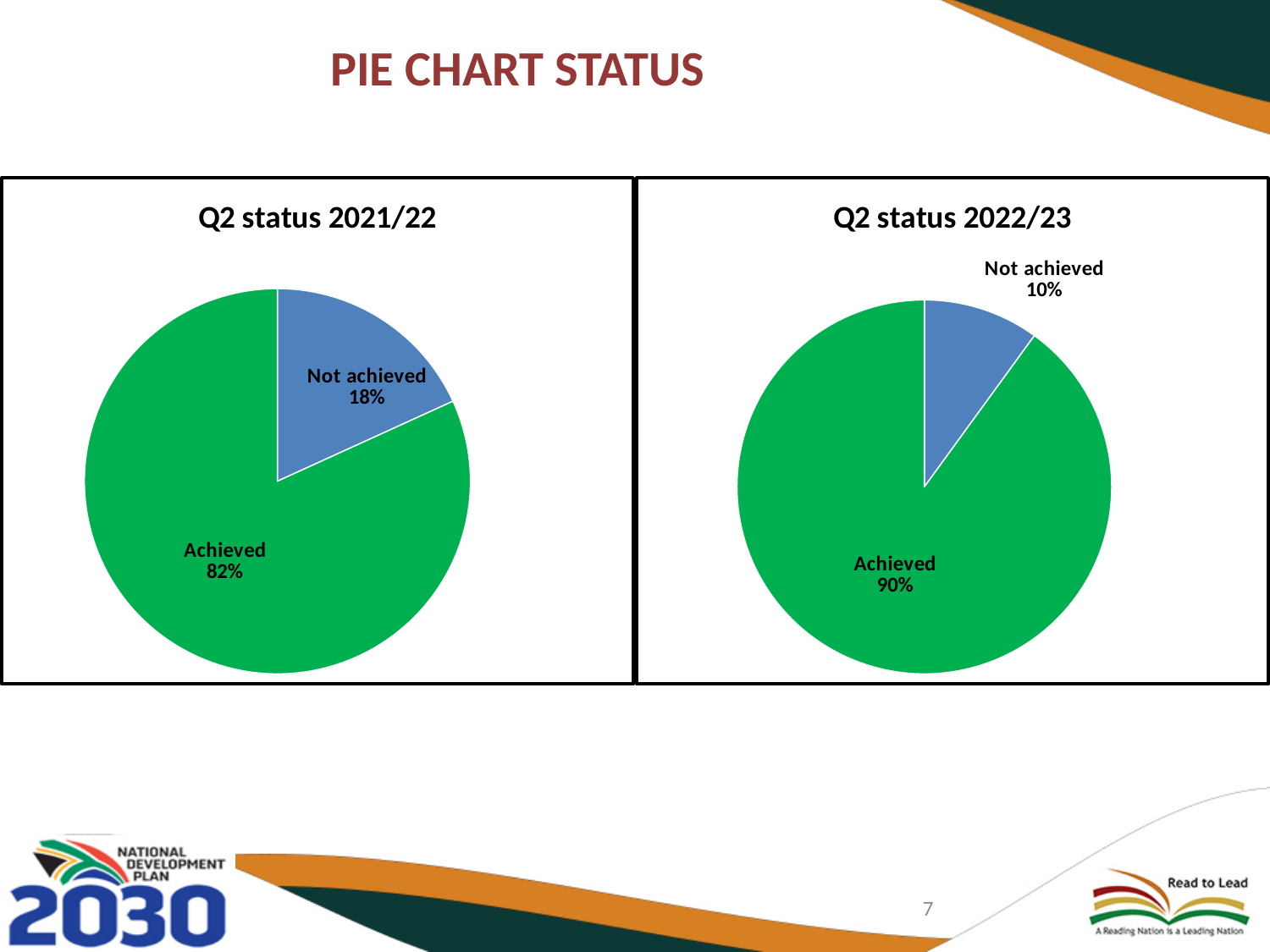
In the 'Q2 status 2022/23' chart, which slice is the smallest? Not achieved Which chart has the larger 'Achieved' share, 'Q2 status 2021/22' or 'Q2 status 2022/23'? Q2 status 2022/23 In the 'Q2 status 2021/22' chart, what share of the pie is 'Not achieved'? 18% How many charts are shown on the slide? 2 In the 'Q2 status 2021/22' chart, what is the difference between the 'Achieved' and 'Not achieved' shares? 64% How many slices does the 'Q2 status 2021/22' pie chart have? 2 In the 'Q2 status 2022/23' chart, what colour is the 'Not achieved' slice? Blue In the 'Q2 status 2021/22' chart, what share of the pie is 'Achieved'? 82% In the 'Q2 status 2022/23' chart, what share of the pie is 'Not achieved'? 10% In the 'Q2 status 2021/22' chart, which slice is the largest? Achieved What kind of chart is the 'Q2 status 2022/23' chart? Pie chart